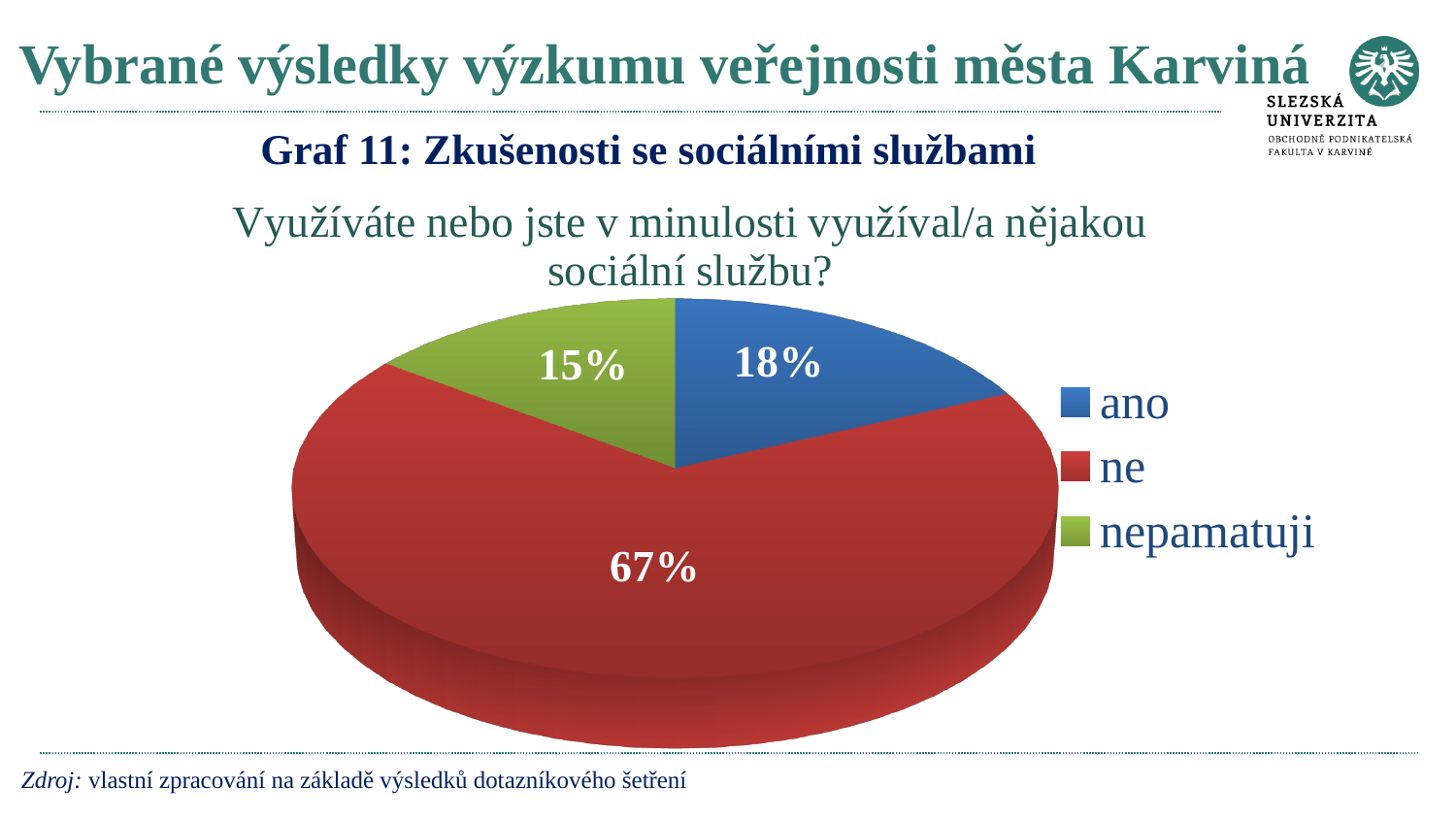
What kind of chart is shown on the slide? pie chart What is the difference in percentage points between "ne" and "ano"? 49 What colour is the slice for "ne"? red How many entries does the legend list? 3 What share of respondents answered "ne"? 67% How many slices does the pie chart have? 3 Which answer has the smallest share of the pie? nepamatuji What share of respondents answered "nepamatuji"? 15% What is the difference in percentage points between "ano" and "nepamatuji"? 3 Which answer has the largest share of the pie? ne What share of respondents answered "ano"? 18% Which is larger, the share for "ano" or the share for "nepamatuji"? ano